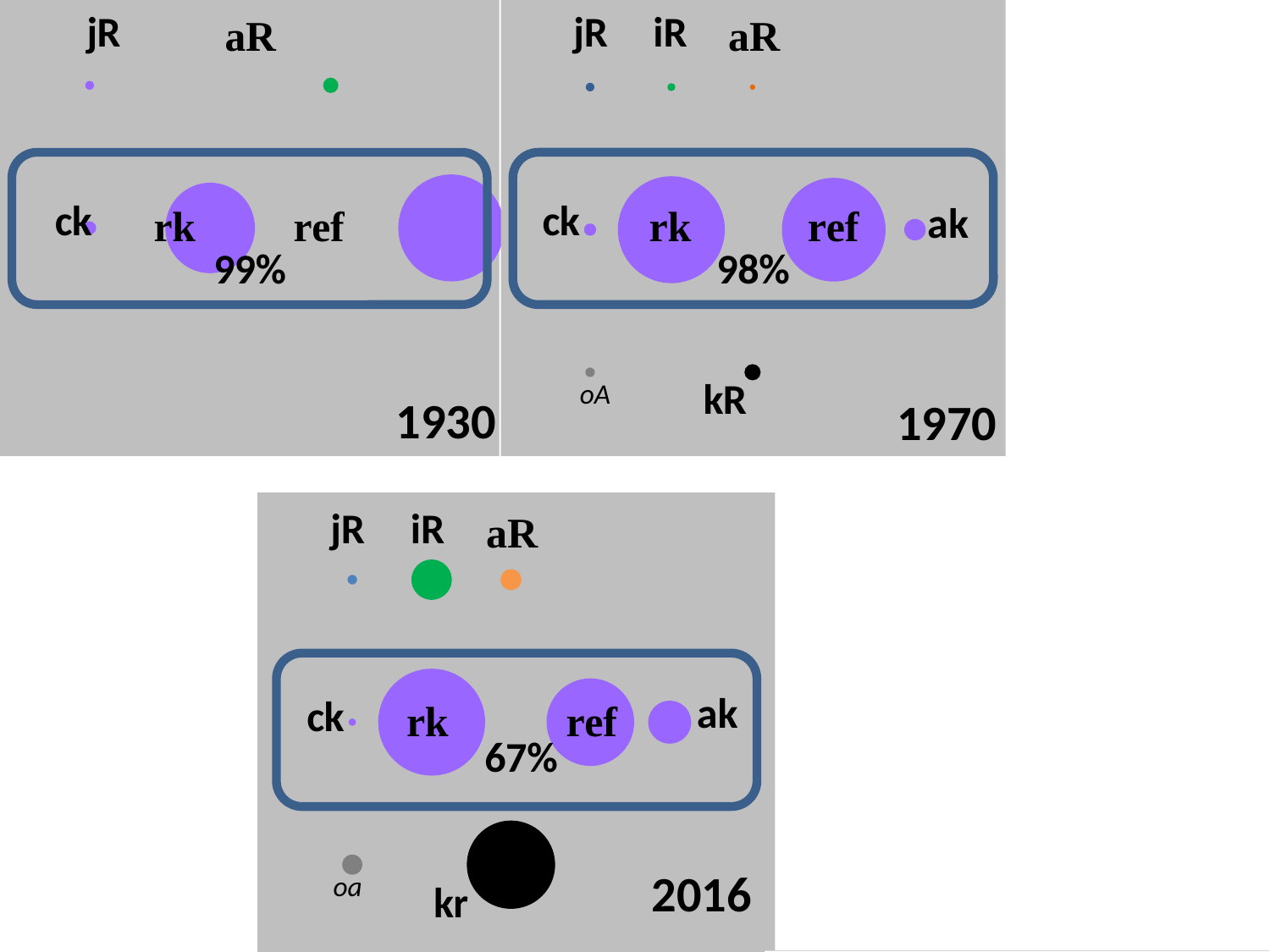
Which year's panel shows the highest percentage inside the outlined box? 1930 What kind of chart is used in each panel? bubble chart What is the difference between the percentage shown for 1930 and the percentage shown for 2016? 32% In the 1930 panel, what percentage is printed inside the outlined box? 99% What is the difference between the percentage shown for 1970 and the percentage shown for 2016? 31% How many year panels are shown on the slide? 3 Which year's panel shows the lowest percentage inside the outlined box? 2016 Is the percentage shown for 1970 larger or smaller than the percentage shown for 2016? larger Which three labels appear inside the outlined box in the 2016 panel alongside 'ck'? rk, ref, ak In the 2016 panel, what percentage is printed inside the outlined box? 67% In the 1970 panel, what percentage is printed inside the outlined box? 98% Does the percentage inside the outlined box rise or fall from 1930 to 2016? fall